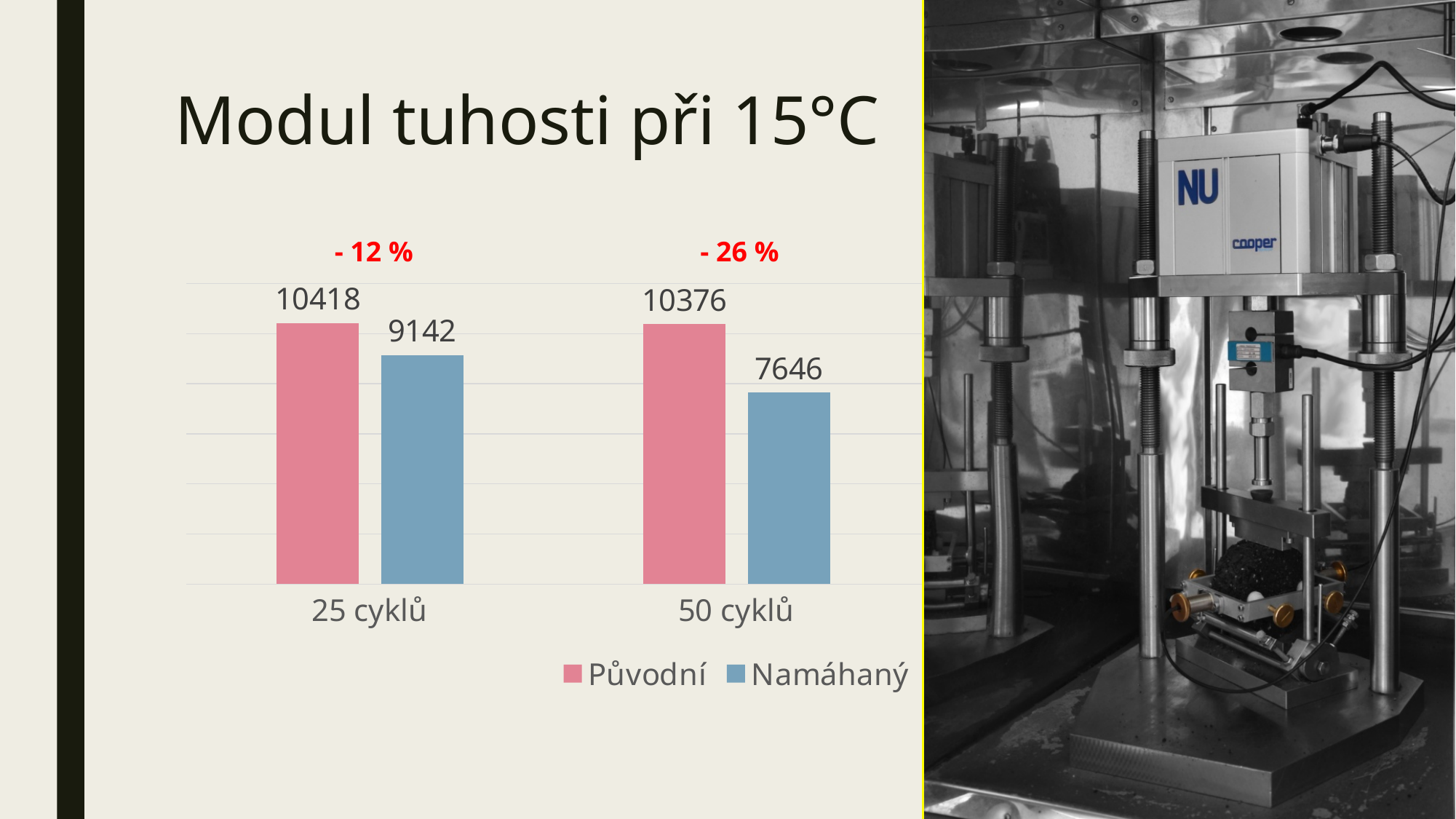
What is the value of Původní for 25 cyklů? 10418 What is the value of Původní for 50 cyklů? 10376 What is the difference between Původní and Namáhaný for 25 cyklů? 1276 What percentage change is annotated above the 50 cyklů bars? - 26 % What is the value of Namáhaný for 50 cyklů? 7646 How many series does the legend list? 2 How many categories are shown on the x axis? 2 Which bar has the lowest value on the chart? Namáhaný, 50 cyklů What is the difference between Původní and Namáhaný for 50 cyklů? 2730 Which is larger: Namáhaný for 25 cyklů or Namáhaný for 50 cyklů? Namáhaný for 25 cyklů What is the value of Namáhaný for 25 cyklů? 9142 What kind of chart is shown on the slide? bar chart